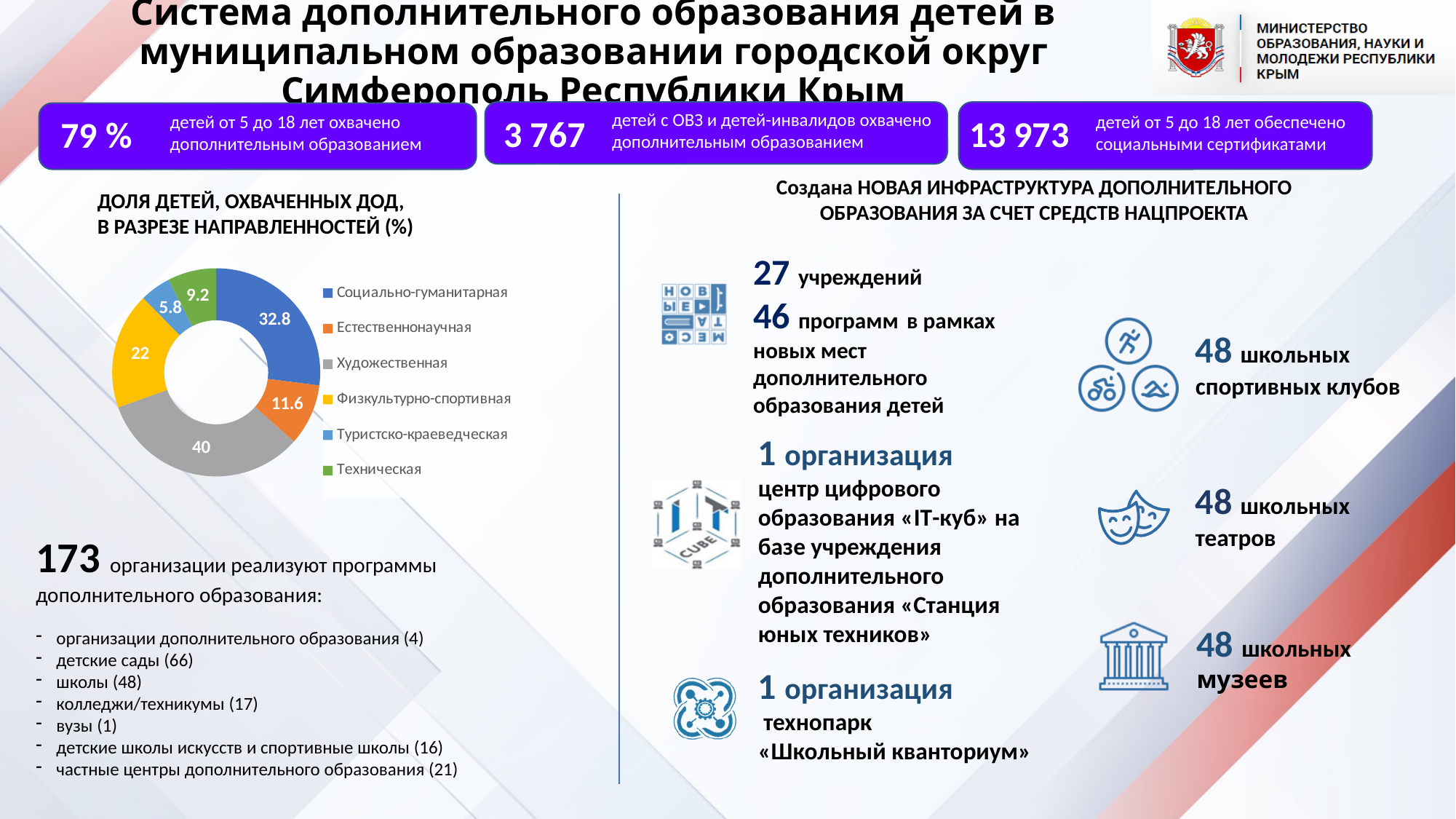
What is the difference between the values for Физкультурно-спортивная and Естественнонаучная in the doughnut chart? 10.4 What type of chart is used to show the share of children covered by additional education by direction? Doughnut (pie) chart What is the value for Социально-гуманитарная in the doughnut chart? 32.8 How many categories does the doughnut chart show? 6 Which is larger in the doughnut chart: Естественнонаучная or Техническая? Естественнонаучная What colour represents Физкультурно-спортивная in the doughnut chart? Yellow Which direction has the largest share in the doughnut chart? Художественная What is the value for Физкультурно-спортивная in the doughnut chart? 22 What is the value for Художественная in the doughnut chart? 40 What is the difference between the values for Художественная and Социально-гуманитарная in the doughnut chart? 7.2 Which direction has the smallest share in the doughnut chart? Туристско-краеведческая What is the value for Туристско-краеведческая in the doughnut chart? 5.8